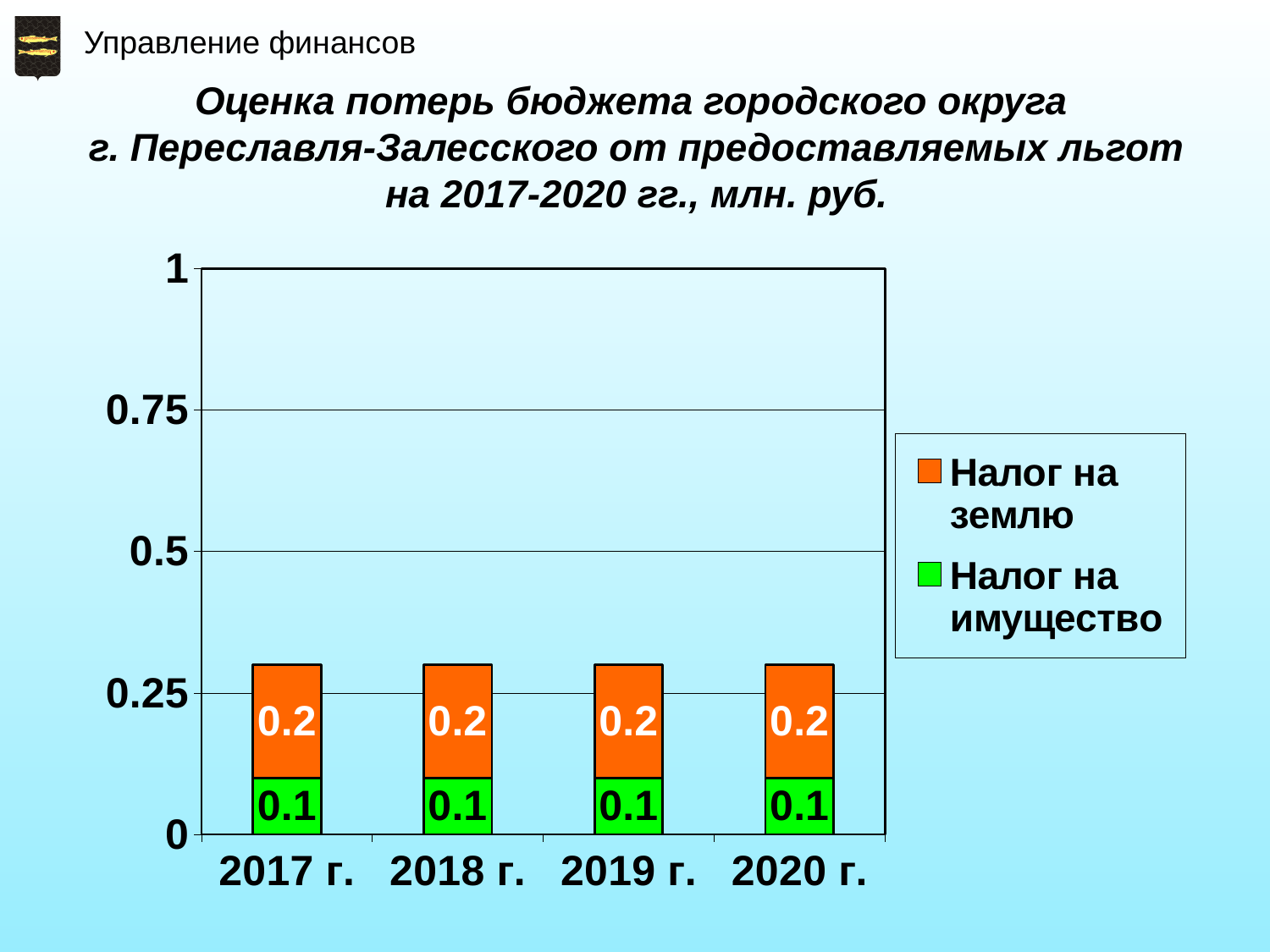
What is the difference between Налог на землю and Налог на имущество in 2017 г.? 0.1 What is the value for Налог на землю in 2017 г.? 0.2 Which colour represents Налог на имущество in the legend? green What kind of chart is shown on the slide? stacked bar chart How many years are shown on the x axis? 4 Which is larger in 2020 г., Налог на землю or Налог на имущество? Налог на землю What is the total of the stacked bar for 2019 г.? 0.3 Do the values for Налог на землю rise, fall or stay the same from 2017 г. to 2020 г.? stay the same Is the total of the stacked bar for 2018 г. greater or less than 0.5? less What is the value for Налог на землю in 2018 г.? 0.2 What is the value for Налог на имущество in 2020 г.? 0.1 How many series does the legend list? 2